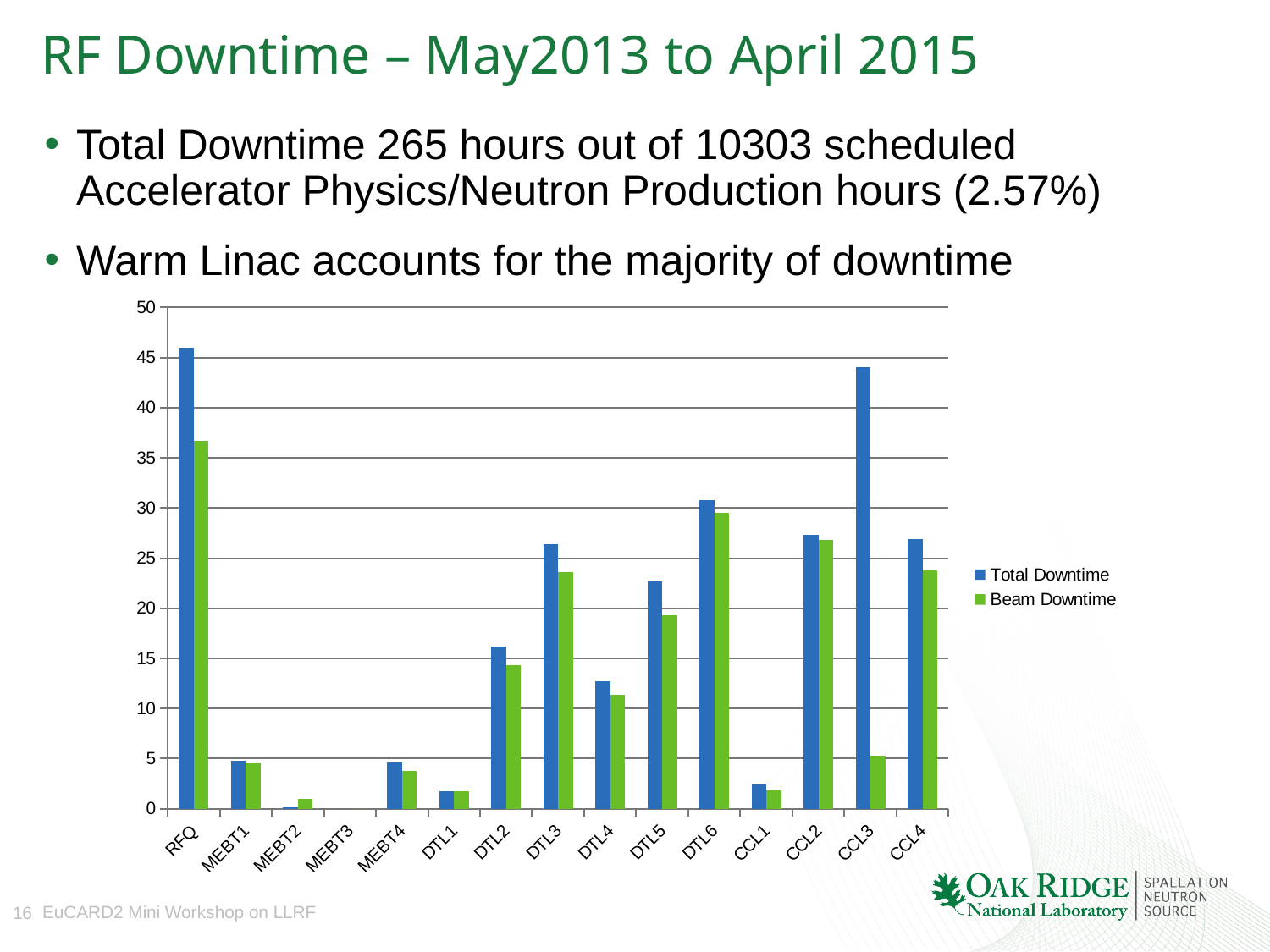
How many categories are shown on the x axis? 15 Is the Beam Downtime for CCL3 greater or less than 10? less Is the Total Downtime for RFQ greater or less than 40? greater How many series does the legend list? 2 What are the two series named in the legend? Total Downtime and Beam Downtime Which category has the highest Beam Downtime? RFQ Which has the larger Total Downtime: DTL5 or DTL4? DTL5 What kind of chart is shown on the slide? bar chart Which category has the highest Total Downtime? RFQ For CCL3, which is larger: Total Downtime or Beam Downtime? Total Downtime Is the Beam Downtime for DTL6 greater or less than 25? greater